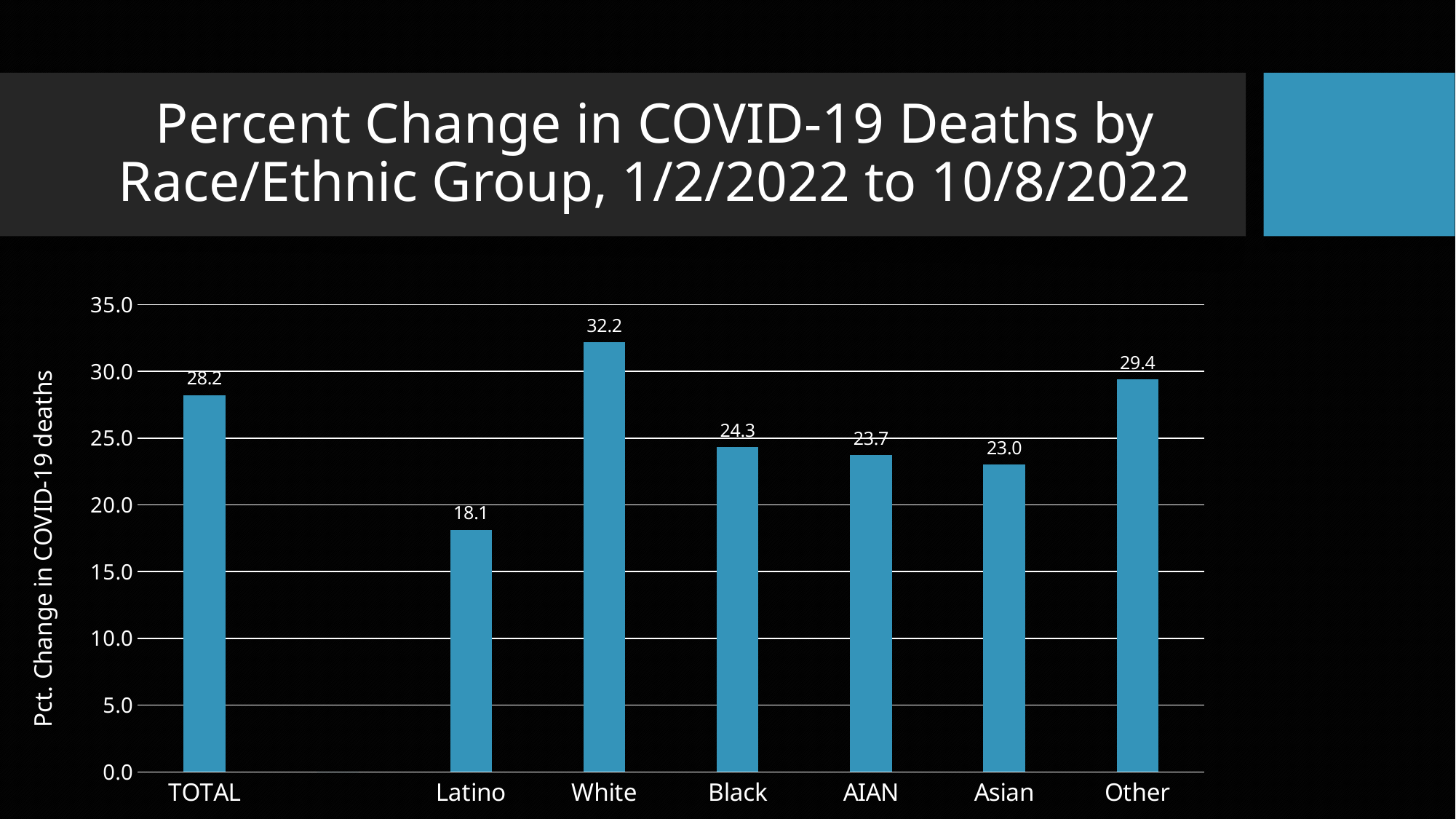
What is the label of the vertical axis? Pct. Change in COVID-19 deaths Which group has the lowest percent change in COVID-19 deaths? Latino What is the percent change in COVID-19 deaths for the Latino group? 18.1 Which group has the highest percent change in COVID-19 deaths? White What kind of chart is shown on the slide? Bar chart What is the percent change in COVID-19 deaths for the White group? 32.2 How many categories are shown on the x axis? 7 What is the difference between the values for White and Latino? 14.1 What is the value shown for the AIAN group? 23.7 Which is larger, the value for Black or the value for Asian? Black What is the difference between the values for Other and TOTAL? 1.2 What is the value shown for TOTAL? 28.2